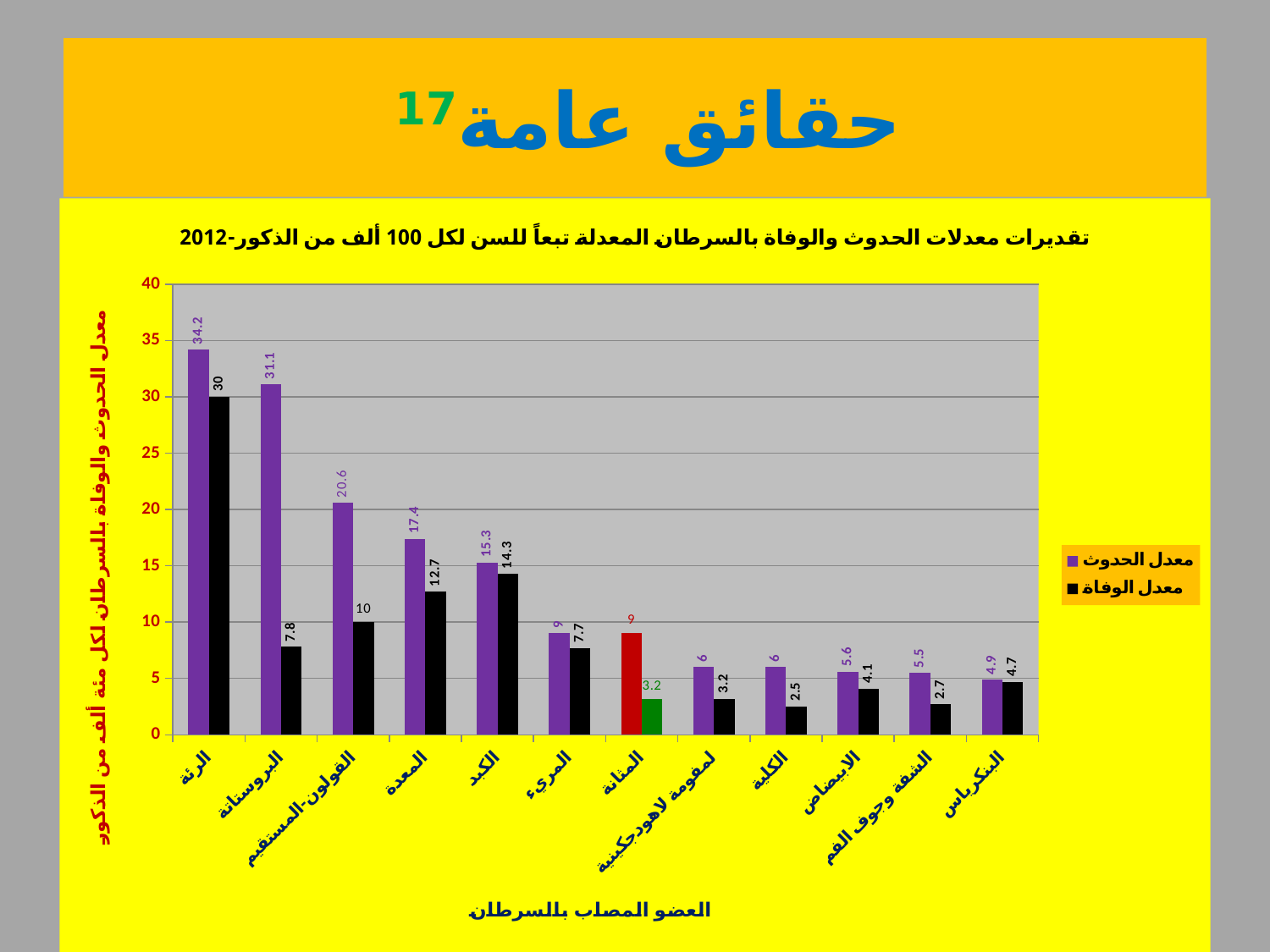
What is the mortality rate (معدل الوفاة) for الكبد? 14.3 What is the mortality rate (معدل الوفاة) for البروستاتة? 7.8 What is the incidence rate (معدل الحدوث) for الرئة? 34.2 Which category has the lowest mortality rate (معدل الوفاة)? الكلية Do the incidence rate (معدل الحدوث) values rise or fall from left to right along the x axis? fall What is the difference between the incidence rate and the mortality rate for البروستاتة? 23.3 Is the mortality rate (معدل الوفاة) for الرئة greater or less than 25? greater How many categories (organs) are shown on the x axis? 12 Which category has the highest incidence rate (معدل الحدوث)? الرئة Which is larger: the incidence rate for القولون-المستقيم or the incidence rate for المعدة? القولون-المستقيم What kind of chart is shown on the slide? bar chart How many series does the legend list? 2